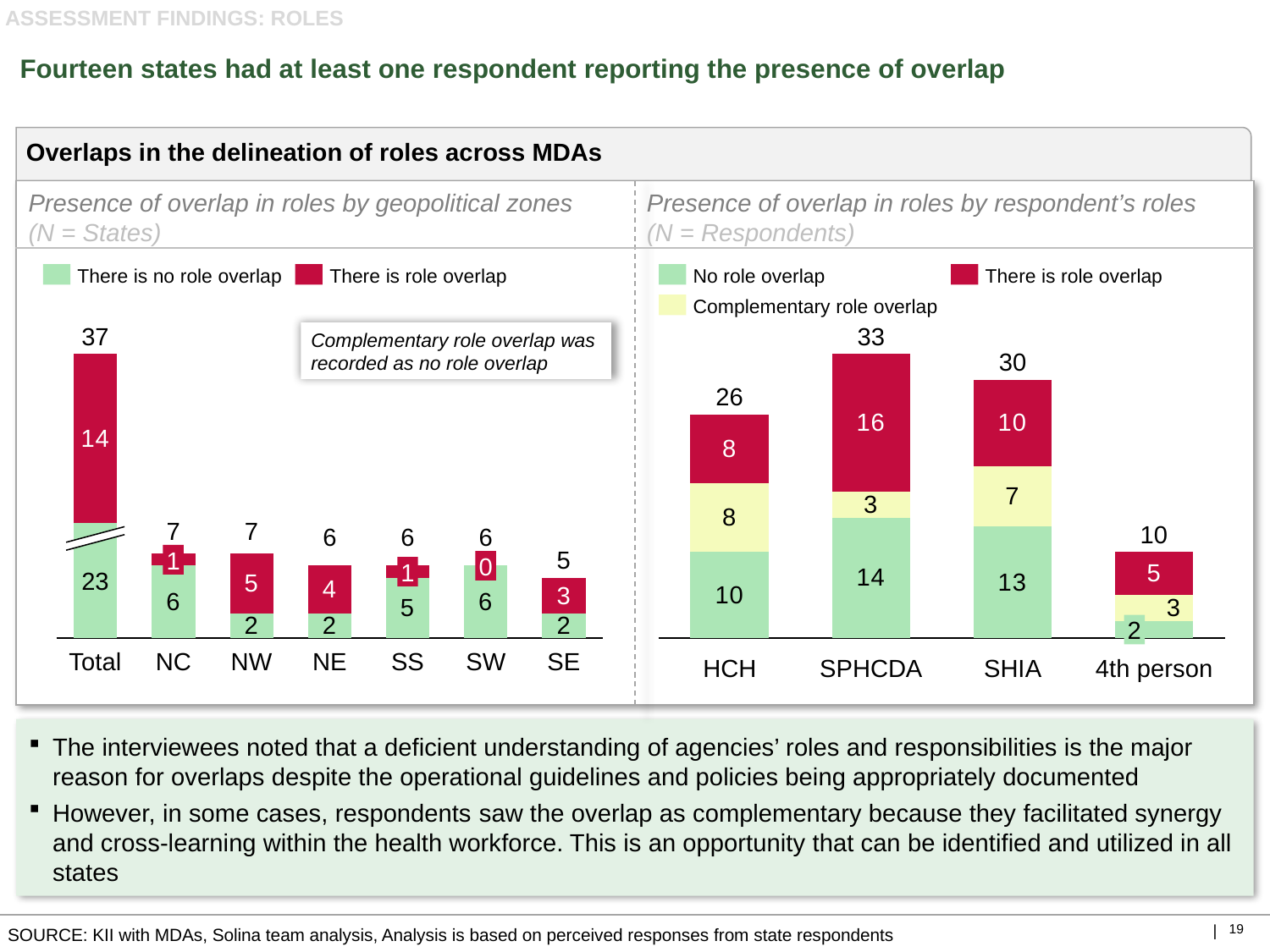
In the chart 'Presence of overlap in roles by geopolitical zones', what is the 'There is role overlap' value for NW? 5 In the chart 'Presence of overlap in roles by respondent's roles', what is the difference between the stacked bar totals for SPHCDA and HCH? 7 In the chart 'Presence of overlap in roles by respondent's roles', what is the 'Complementary role overlap' value for SHIA? 7 In the chart 'Presence of overlap in roles by respondent's roles', how many respondent role categories are shown on the x axis? 4 What type of chart is 'Presence of overlap in roles by respondent's roles'? Stacked bar chart In the chart 'Presence of overlap in roles by geopolitical zones', what is the total of the SE stacked bar? 5 In the chart 'Presence of overlap in roles by respondent's roles', which respondent role has the highest stacked bar total? SPHCDA In the chart 'Presence of overlap in roles by geopolitical zones', how many series does the legend list? 2 In the chart 'Presence of overlap in roles by geopolitical zones', what is the 'There is no role overlap' value for the Total bar? 23 In the chart 'Presence of overlap in roles by respondent's roles', is the 'No role overlap' value larger for SPHCDA or for SHIA? SPHCDA In the chart 'Presence of overlap in roles by respondent's roles', what is the 'There is role overlap' value for SPHCDA? 16 In the chart 'Presence of overlap in roles by geopolitical zones', which zone (excluding Total) has the lowest stacked bar total? SE